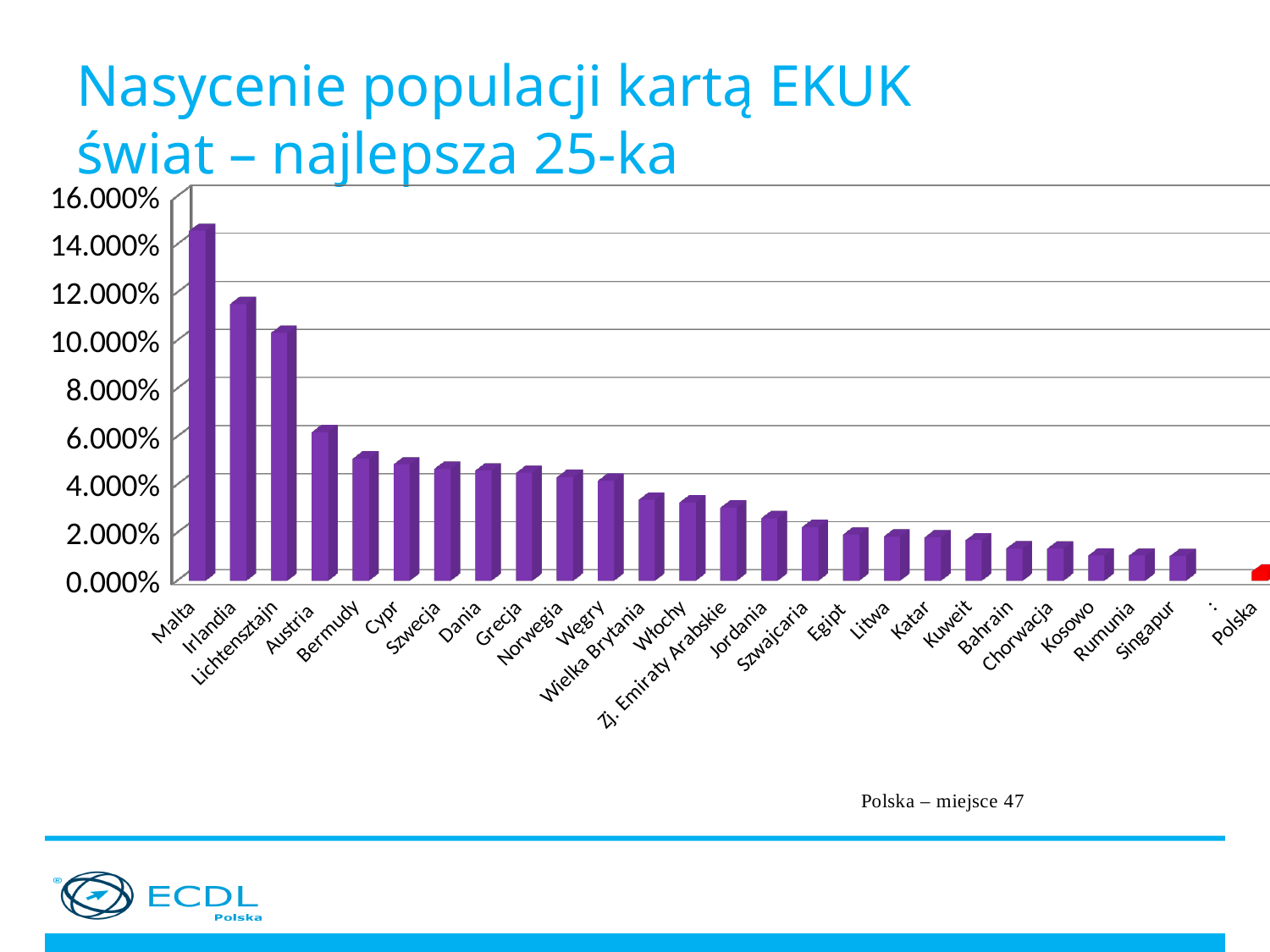
Which country has the highest value in the chart? Malta Is the value for Lichtensztajn greater or less than 8.000%? greater Which has a larger value, Irlandia or Austria? Irlandia Is the value for Bermudy greater or less than 4.000%? greater What kind of chart is shown on the slide? bar chart Do the values rise or fall moving from left to right along the x axis? fall Is the value for Irlandia greater or less than 10.000%? greater Which category has the lowest bar in the chart? Polska What colour is the bar for Polska? red